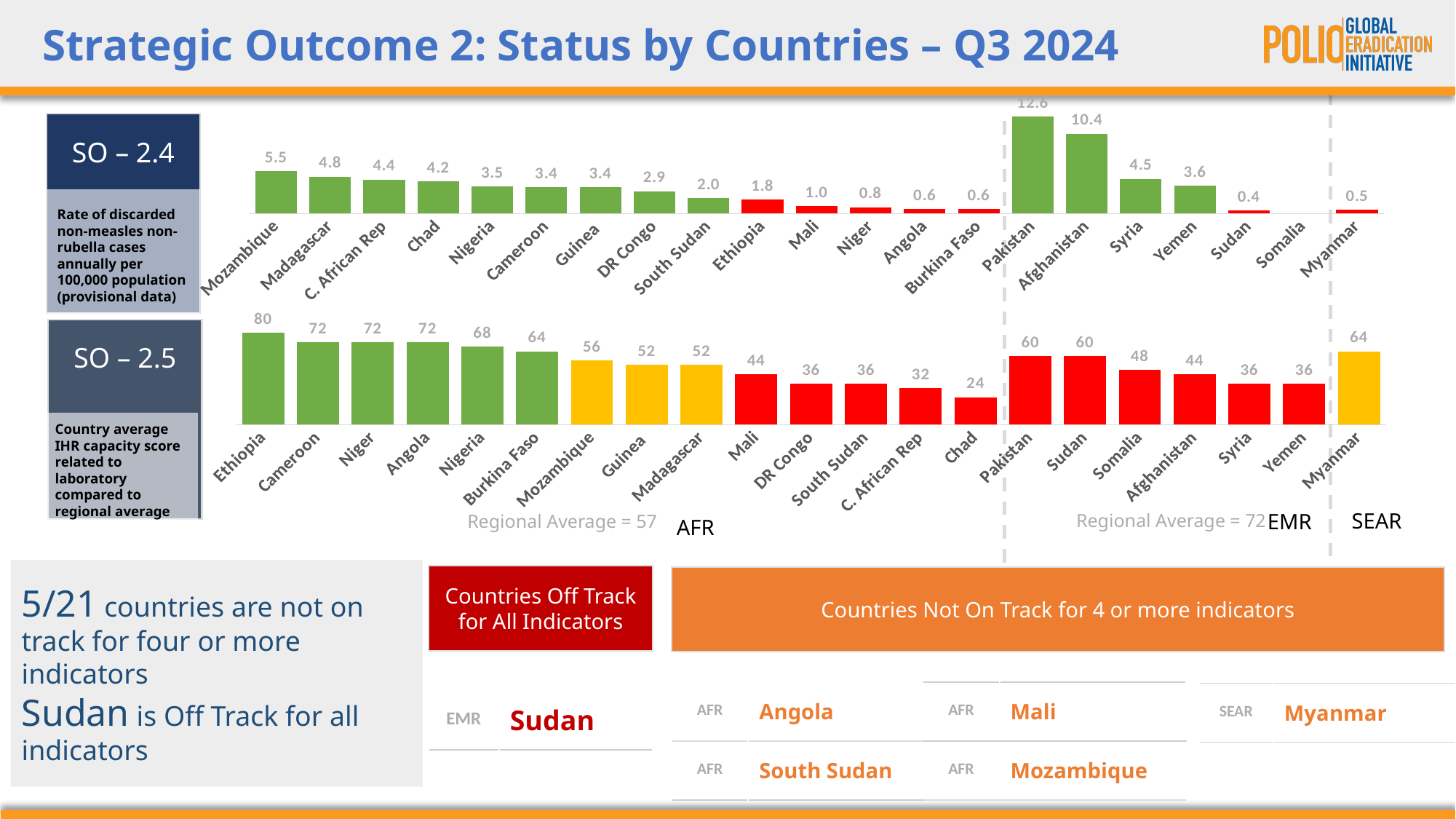
In the SO – 2.5 chart, what is the value for Chad? 24 In the SO – 2.5 chart, which country has the lowest value? Chad How many countries are shown in the SO – 2.5 chart? 21 In the SO – 2.4 chart, what is the value for Pakistan? 12.6 In the SO – 2.5 chart, what is the value for Ethiopia? 80 What type of chart is the SO – 2.4 chart? Bar chart In the SO – 2.4 chart, which is larger, the value for Chad or the value for Syria? Syria In the SO – 2.5 chart, what is the difference between Ethiopia and Myanmar? 16 In the SO – 2.4 chart, what is the difference between Pakistan and Afghanistan? 2.2 In the SO – 2.5 chart, which is larger, the value for Somalia or the value for Mali? Somalia In the SO – 2.4 chart, which country has the highest value? Pakistan In the SO – 2.4 chart, what is the value for Mozambique? 5.5